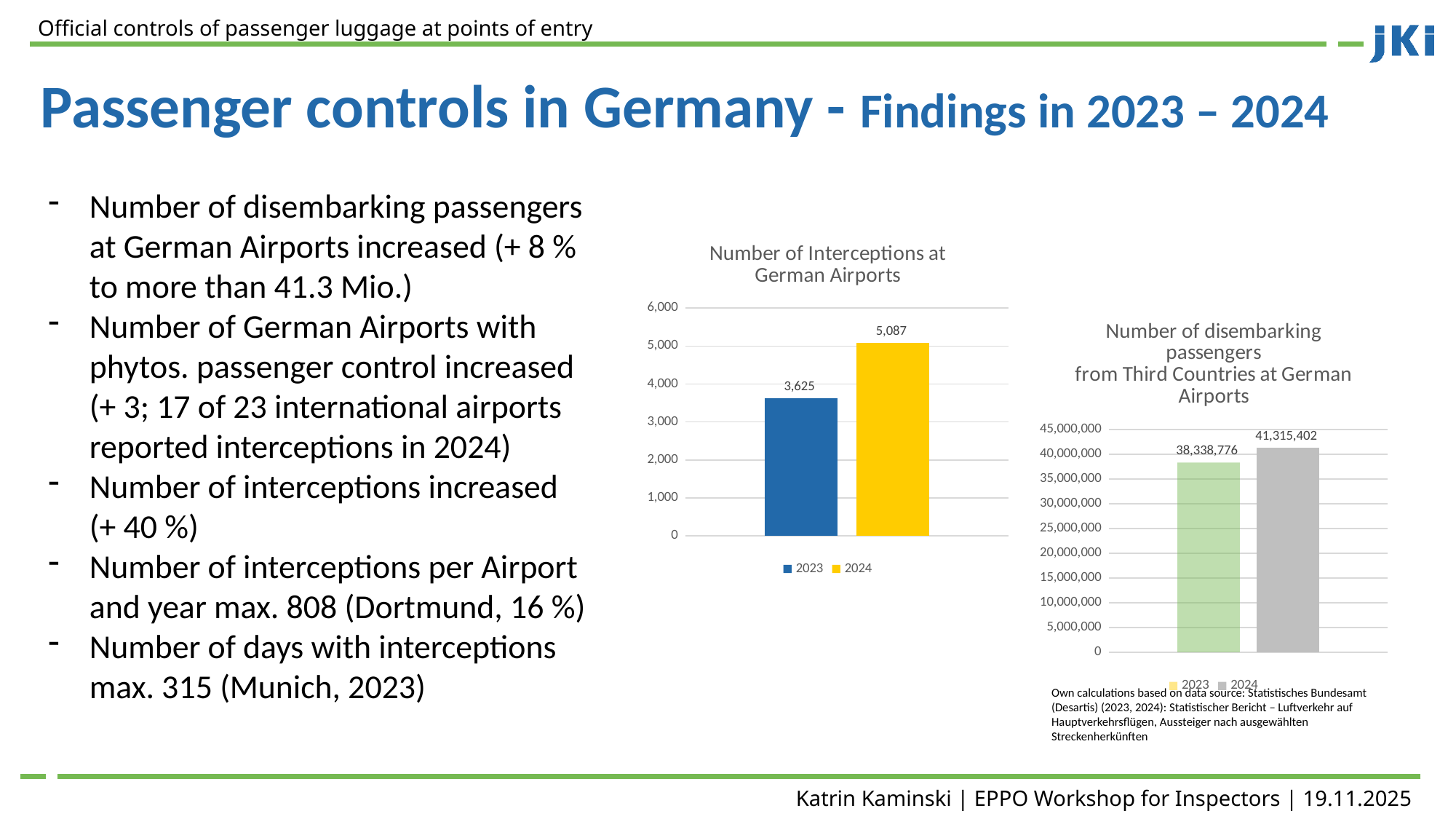
In the chart 'Number of disembarking passengers from Third Countries at German Airports', what is the value for 2024? 41,315,402 In the chart 'Number of Interceptions at German Airports', is the value for 2024 greater or less than 4,000? greater What kind of chart is 'Number of Interceptions at German Airports'? bar chart In the chart 'Number of disembarking passengers from Third Countries at German Airports', what is the difference between the 2024 and 2023 values? 2,976,626 In the chart 'Number of Interceptions at German Airports', what is the value for 2023? 3,625 In the chart 'Number of Interceptions at German Airports', what is the value for 2024? 5,087 In the chart 'Number of Interceptions at German Airports', which year has the higher value? 2024 In the chart 'Number of Interceptions at German Airports', how many series does the legend list? 2 In the chart 'Number of disembarking passengers from Third Countries at German Airports', what is the value for 2023? 38,338,776 In the chart 'Number of disembarking passengers from Third Countries at German Airports', is the value for 2023 greater or less than 40,000,000? less In the chart 'Number of Interceptions at German Airports', what is the difference between the 2024 and 2023 values? 1,462 In the chart 'Number of disembarking passengers from Third Countries at German Airports', which year has the lower value? 2023